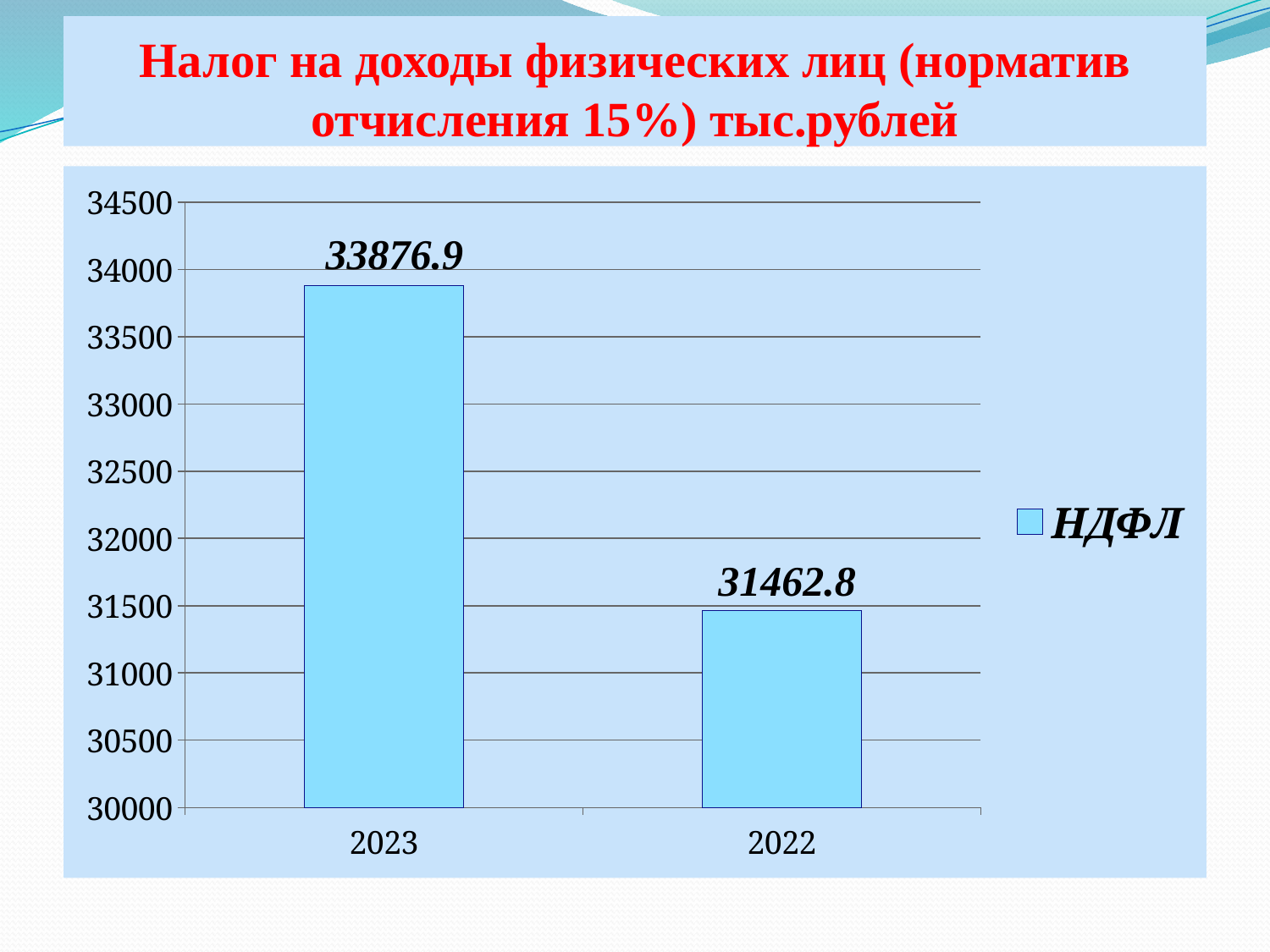
What is the value for 2022? 31462.8 What is the value for 2023? 33876.9 How many categories are shown on the x axis? 2 Which year has the lowest value? 2022 What kind of chart is shown on the slide? bar chart Which is larger, the value for 2023 or the value for 2022? 2023 How many series does the legend list? 1 Is the value for 2023 greater or less than 33500? greater Which year has the highest value? 2023 What is the difference between the values for 2023 and 2022? 2414.1 Is the value for 2022 greater or less than 32000? less What is the name of the series in the legend? НДФЛ